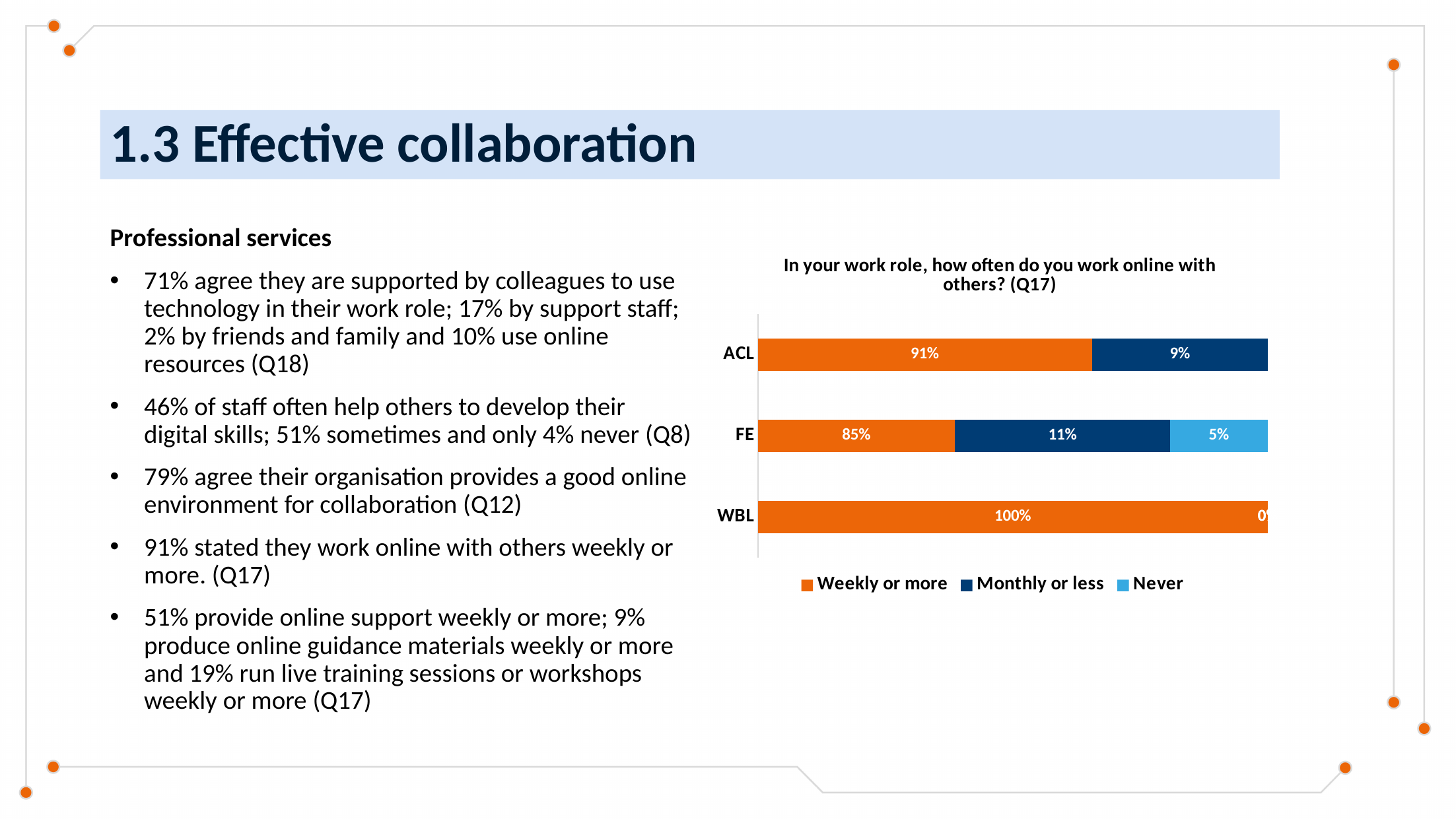
Which category has the highest 'Weekly or more' value? WBL What is the value for 'Monthly or less' for ACL? 9% How many categories are shown on the chart? 3 Which category has the lowest 'Weekly or more' value? FE Which is larger: the 'Monthly or less' value for FE or for ACL? FE What is the value for 'Weekly or more' for WBL? 100% What is the value for 'Weekly or more' for ACL? 91% What is the value for 'Monthly or less' for FE? 11% What is the difference between the 'Weekly or more' values for ACL and FE? 6% How many series does the legend list? 3 What kind of chart is shown on the slide? Stacked bar chart What is the value for 'Never' for FE? 5%